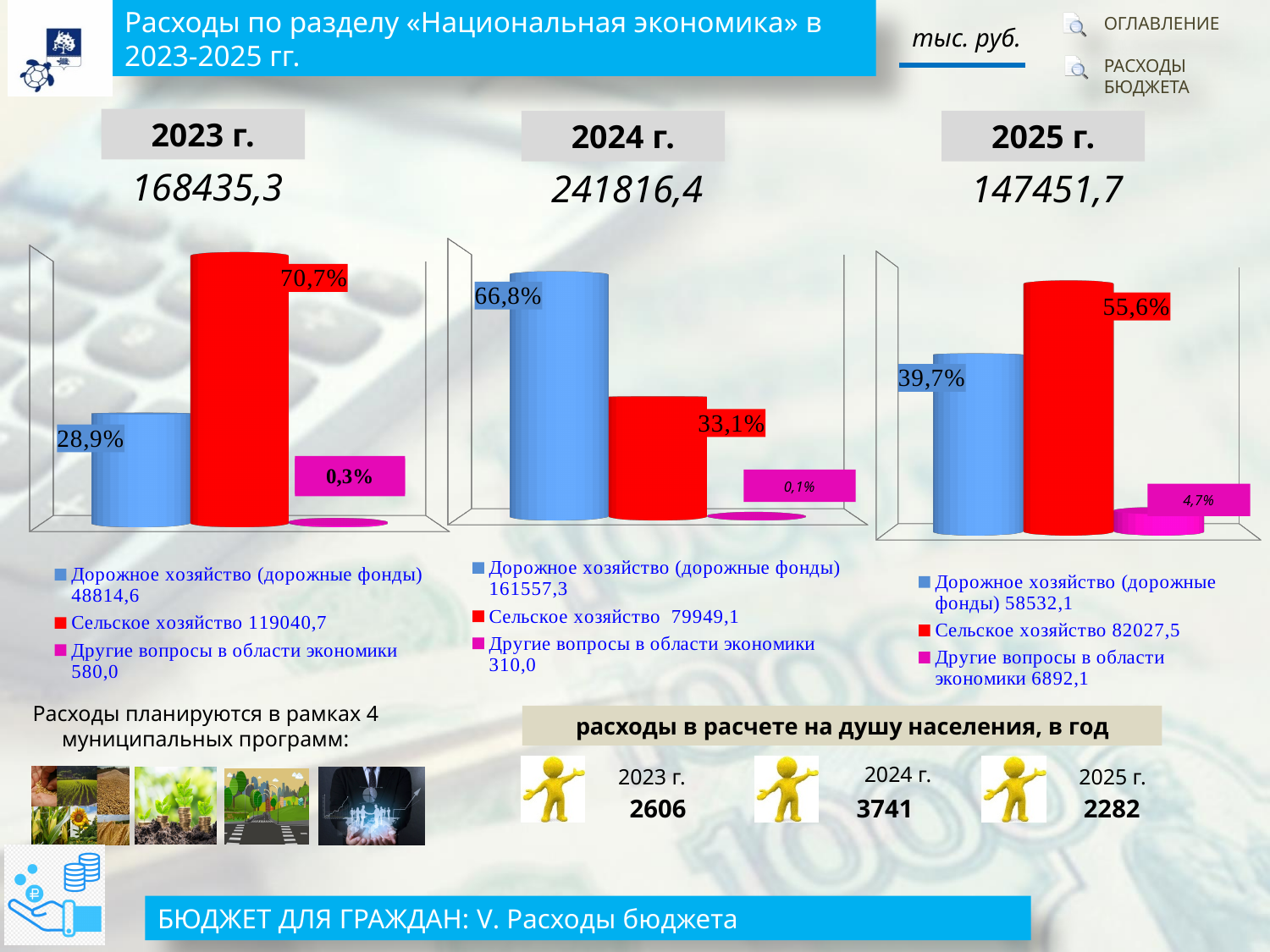
Какого типа диаграмма за 2024 г.? Столбчатая (bar chart) На диаграмме за 2025 г. какая категория имеет наибольшую долю? Сельское хозяйство Сколько категорий показано на диаграмме за 2023 г.? 3 На диаграмме за 2025 г. на сколько процентных пунктов доля «Сельского хозяйства» больше доли «Дорожного хозяйства»? 15,9 На диаграмме за 2024 г. что больше: доля «Дорожного хозяйства» или доля «Сельского хозяйства»? Дорожное хозяйство Каким цветом на диаграммах обозначена категория «Другие вопросы в области экономики»? Розовым (пурпурным) На диаграмме за 2023 г. какая доля приходится на «Сельское хозяйство»? 70,7% Согласно легенде диаграммы за 2024 г., какова сумма расходов на «Сельское хозяйство» (тыс. руб.)? 79949,1 На диаграмме за 2023 г. какая категория имеет наибольшую долю? Сельское хозяйство На диаграмме за 2024 г. какая доля приходится на «Дорожное хозяйство (дорожные фонды)»? 66,8% На диаграмме за 2024 г. какая категория имеет наименьшую долю? Другие вопросы в области экономики На диаграмме за 2025 г. какая доля приходится на «Другие вопросы в области экономики»? 4,7%